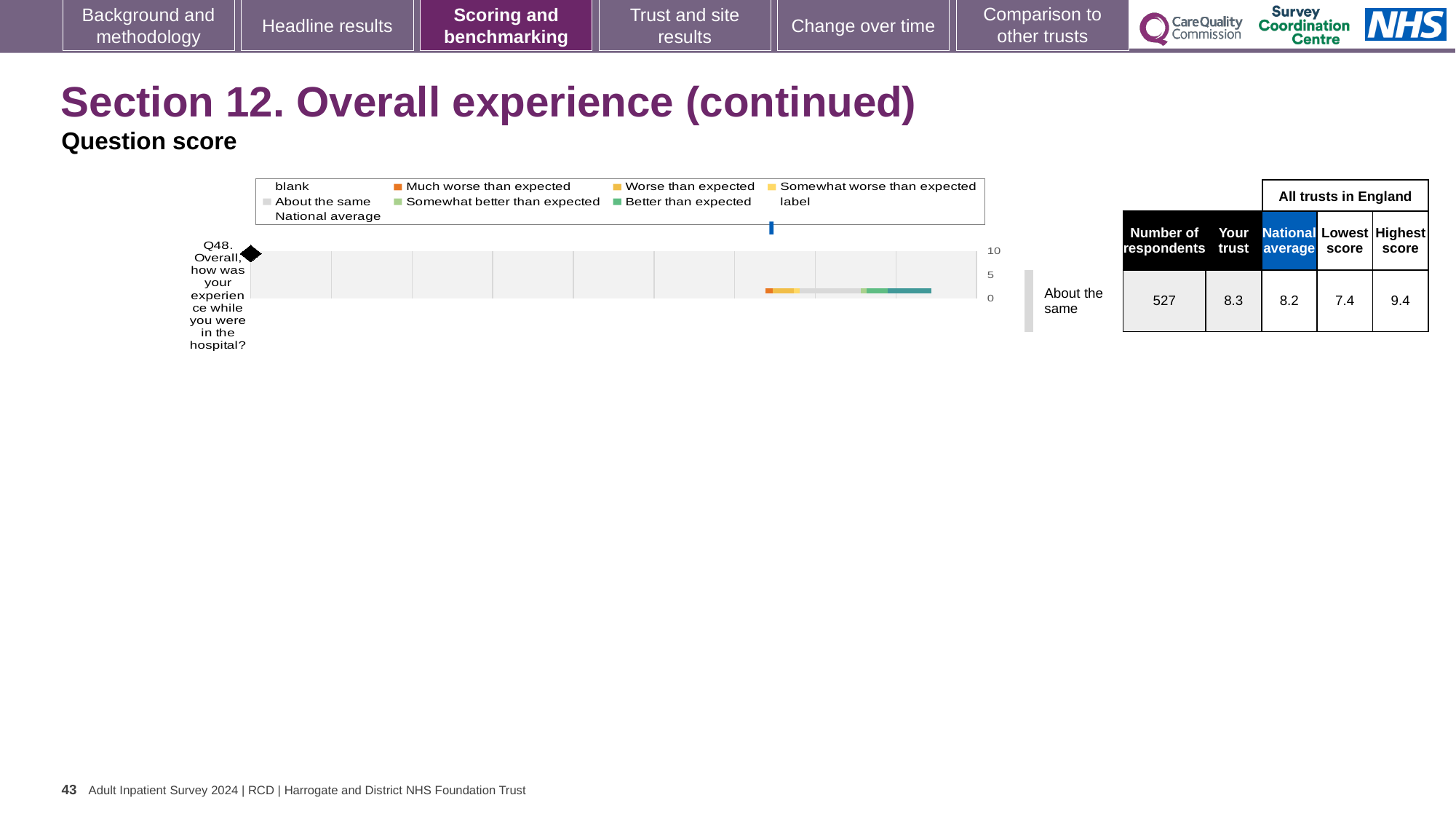
What kind of chart is used to show the Q48 question score? bar chart How many entries does the chart legend list? 9 Which question is plotted on the chart? Q48. Overall, how was your experience while you were in the hospital? What is the highest score among all trusts in England for Q48? 9.4 What is the difference between the highest and lowest scores for Q48 across all trusts in England? 2.0 What is the highest value shown on the chart's axis? 10 How many questions are plotted on the chart? 1 How many respondents answered Q48? 527 What is the national average score for Q48 shown beside the chart? 8.2 Which is larger for Q48, the trust's score or the national average? the trust's score What is the trust's score for Q48 according to the table beside the chart? 8.3 What is the lowest score among all trusts in England for Q48? 7.4